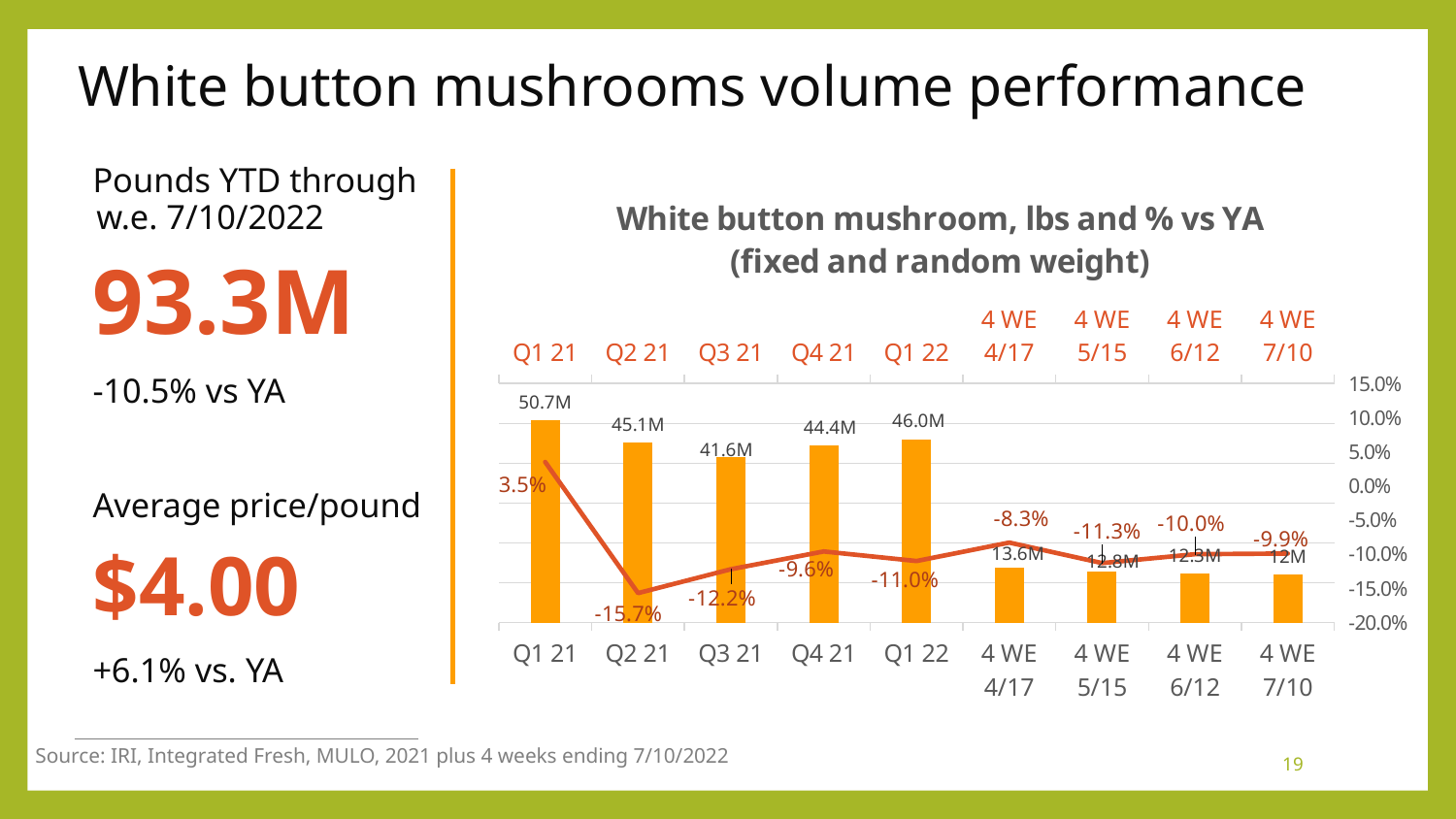
What is the % vs YA value for Q1 22? -11.0% What is the volume in pounds for Q1 21? 50.7M Which period has the lowest % vs YA value? Q2 21 Which period has the highest volume in pounds? Q1 21 What is the title of the chart? White button mushroom, lbs and % vs YA (fixed and random weight) How many periods are shown on the x axis? 9 Does the volume in pounds rise or fall from Q1 21 to Q3 21? Fall What is the difference in pounds between Q1 21 and Q2 21? 5.6M What kind of chart is this? Combined bar and line chart What is the volume in pounds for the 4 WE 7/10 period? 12M Which is larger, the volume for Q4 21 or Q1 22? Q1 22 What is the % vs YA value for Q2 21? -15.7%